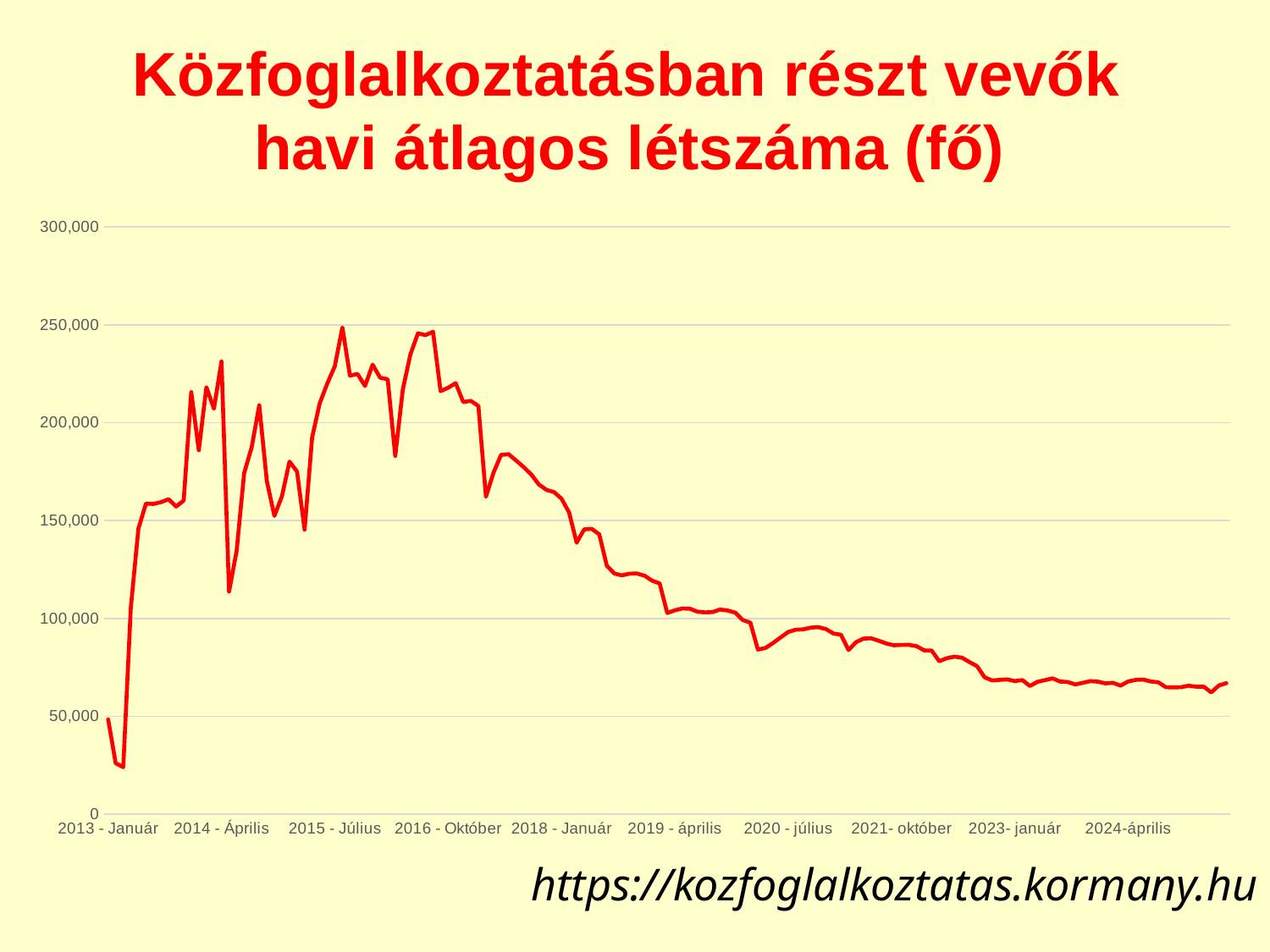
Is the value at 2018 - Január greater or less than 150,000? greater Is the value at 2024-április greater or less than 100,000? less Is the lowest point of the line greater or less than 50,000? less Do the values rise or fall along the x axis from 2016 - Október to 2024-április? fall Which is larger, the value at 2014 - Április or the value at 2021- október? 2014 - Április What colour is the plotted line? red What is the title of the chart? Közfoglalkoztatásban részt vevők havi átlagos létszáma (fő) What kind of chart is shown on the slide? line chart